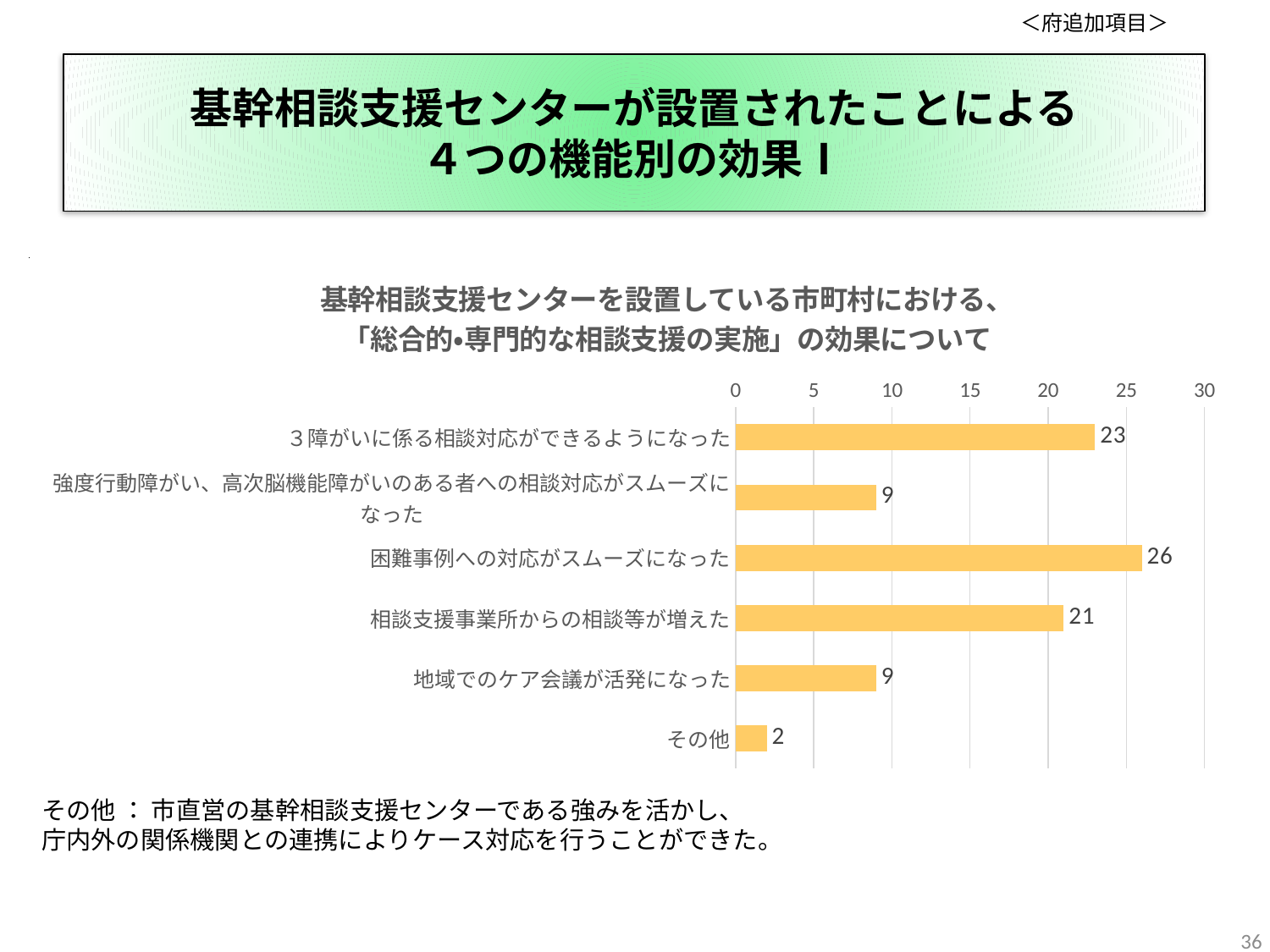
What is the difference between the values for 困難事例への対応がスムーズになった and 相談支援事業所からの相談等が増えた? 5 What is the value for 困難事例への対応がスムーズになった? 26 Which category has the highest value? 困難事例への対応がスムーズになった What is the value for その他? 2 Which category has the lowest value? その他 Which is larger: the value for ３障がいに係る相談対応ができるようになった or the value for 地域でのケア会議が活発になった? ３障がいに係る相談対応ができるようになった What is the maximum value shown on the chart's axis? 30 How many categories are shown in the chart? 6 What kind of chart is shown on the slide? bar chart What is the value for ３障がいに係る相談対応ができるようになった? 23 What is the value for 相談支援事業所からの相談等が増えた? 21 Is the value for 相談支援事業所からの相談等が増えた greater or less than 15? greater